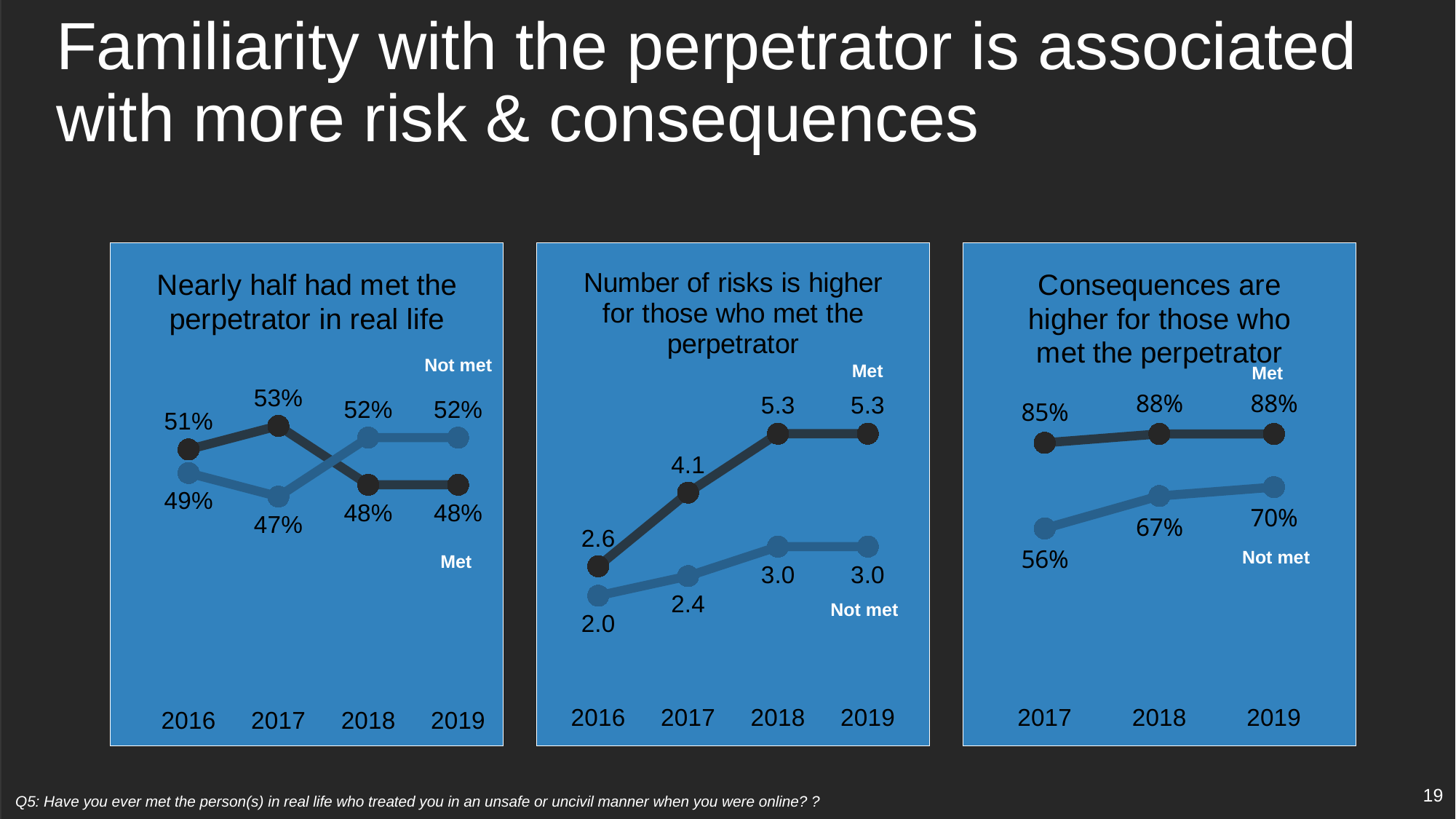
In the chart titled "Number of risks is higher for those who met the perpetrator", does the Met line rise or fall from 2016 to 2018? rise In the chart titled "Nearly half had met the perpetrator in real life", what is the difference between Met and Not met in 2017? 6 percentage points In the chart titled "Nearly half had met the perpetrator in real life", what is the value for Met in 2017? 53% In the chart titled "Consequences are higher for those who met the perpetrator", how many years are shown on the x axis? 3 In the chart titled "Number of risks is higher for those who met the perpetrator", what is the difference between Met and Not met in 2019? 2.3 What kind of chart is the middle chart on the slide? line chart In the chart titled "Number of risks is higher for those who met the perpetrator", in which year is the Met value lowest? 2016 In the chart titled "Consequences are higher for those who met the perpetrator", which is larger in 2019, Met or Not met? Met In the chart titled "Consequences are higher for those who met the perpetrator", what is the value for Not met in 2017? 56% In the chart titled "Number of risks is higher for those who met the perpetrator", what is the value for Met in 2017? 4.1 In the chart titled "Nearly half had met the perpetrator in real life", what is the value for Not met in 2019? 52% In the chart titled "Number of risks is higher for those who met the perpetrator", what is the value for Not met in 2016? 2.0